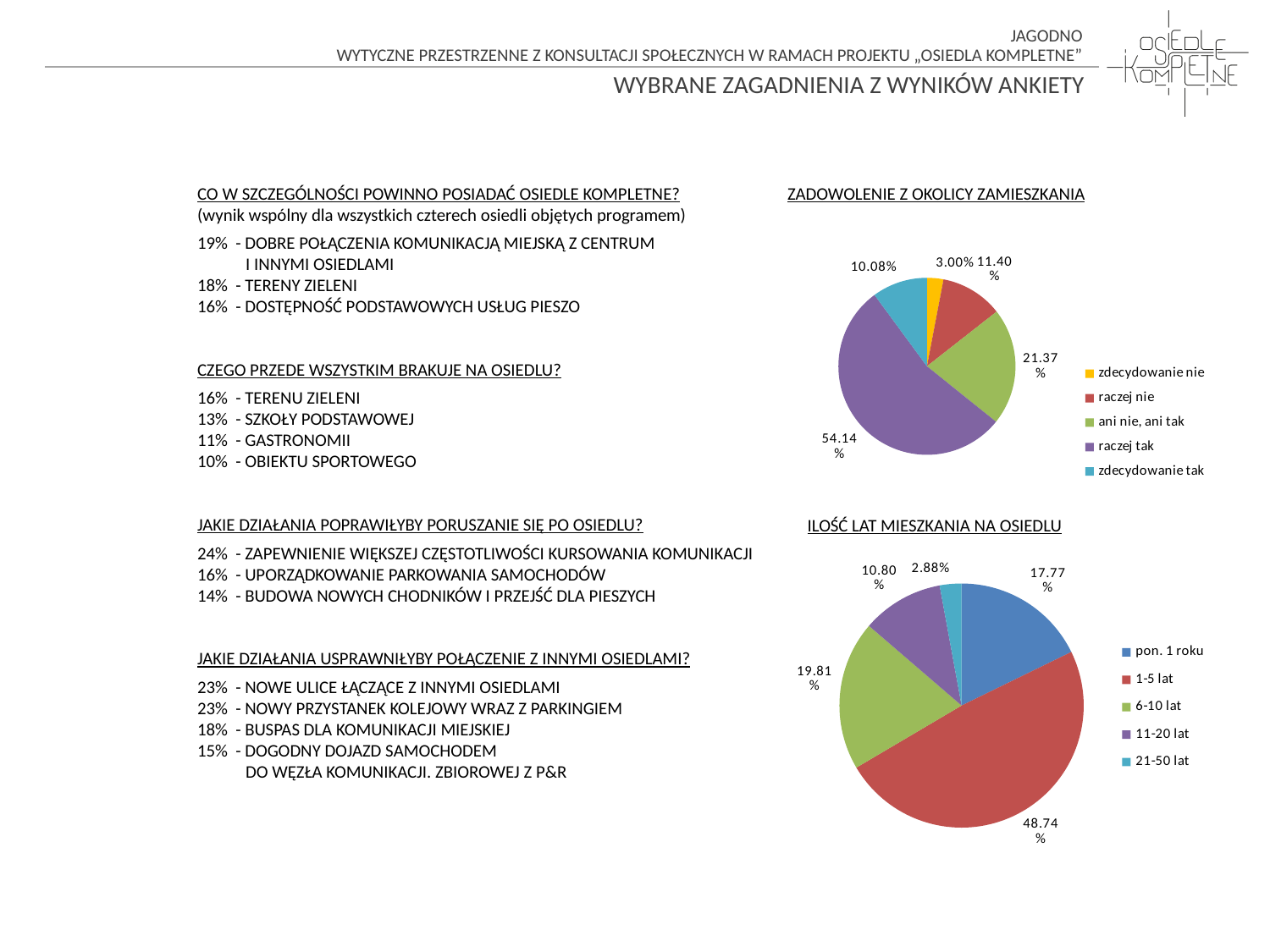
In the 'ZADOWOLENIE Z OKOLICY ZAMIESZKANIA' chart, what percentage is shown for 'ani nie, ani tak'? 21.37% In the 'ZADOWOLENIE Z OKOLICY ZAMIESZKANIA' chart, what percentage is shown for 'raczej tak'? 54.14% In the 'ILOŚĆ LAT MIESZKANIA NA OSIEDLU' chart, what percentage is shown for '1-5 lat'? 48.74% What type of chart is 'ILOŚĆ LAT MIESZKANIA NA OSIEDLU'? pie chart In the 'ILOŚĆ LAT MIESZKANIA NA OSIEDLU' chart, what is the difference between '1-5 lat' and '11-20 lat'? 37.94% In the 'ZADOWOLENIE Z OKOLICY ZAMIESZKANIA' chart, which category has the smallest share? zdecydowanie nie In the 'ILOŚĆ LAT MIESZKANIA NA OSIEDLU' chart, what percentage is shown for '21-50 lat'? 2.88% In the 'ILOŚĆ LAT MIESZKANIA NA OSIEDLU' chart, which is larger: 'pon. 1 roku' or '6-10 lat'? 6-10 lat How many categories does the legend of the 'ZADOWOLENIE Z OKOLICY ZAMIESZKANIA' chart list? 5 In the 'ZADOWOLENIE Z OKOLICY ZAMIESZKANIA' chart, which category has the largest share? raczej tak In the 'ILOŚĆ LAT MIESZKANIA NA OSIEDLU' chart, what colour is the '1-5 lat' slice? red In the 'ZADOWOLENIE Z OKOLICY ZAMIESZKANIA' chart, what is the difference between 'raczej nie' and 'zdecydowanie tak'? 1.32%